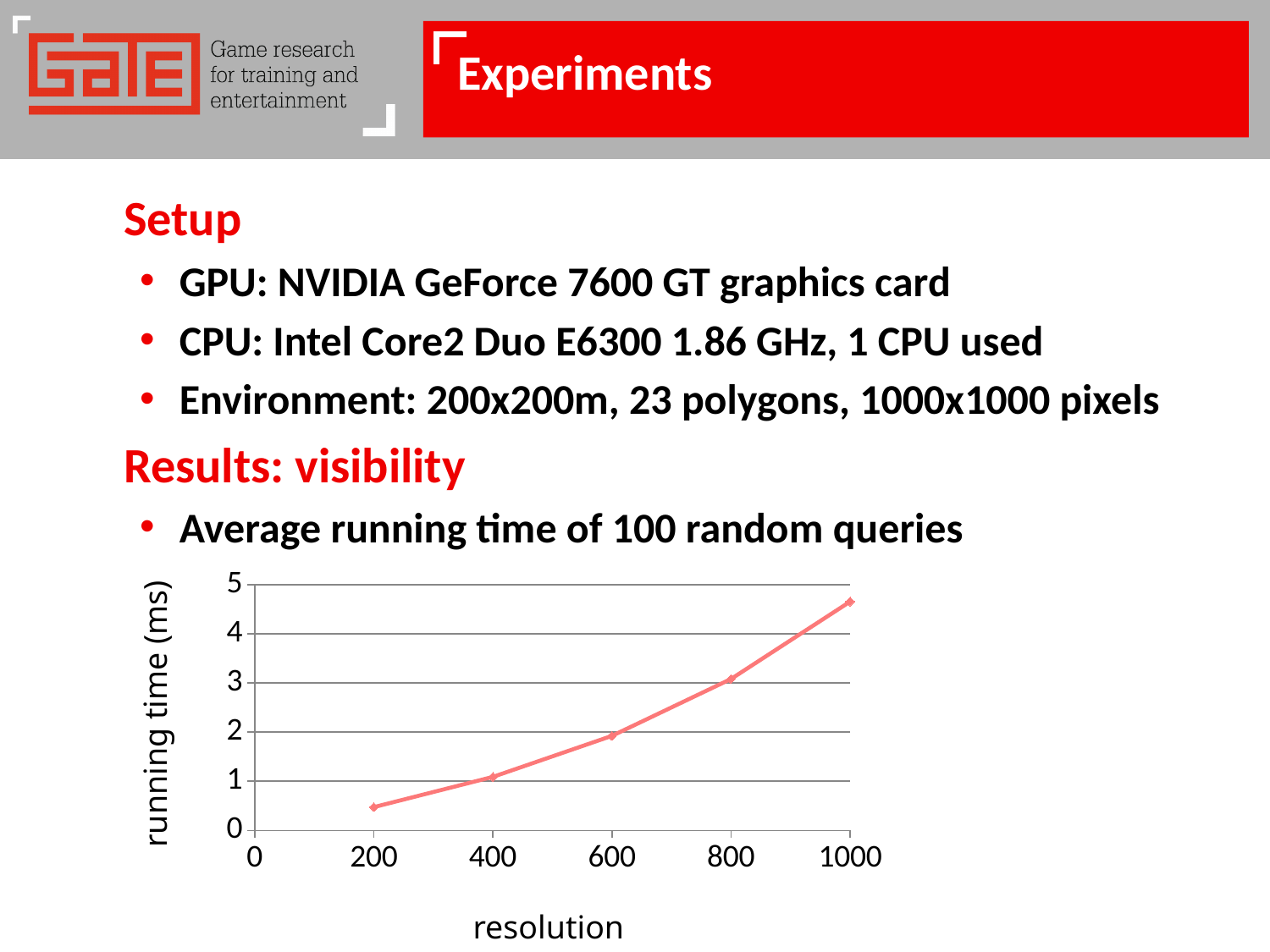
Is the running time at resolution 400 greater or less than 2 ms? less At which resolution is the running time lowest? 200 What is the label of the y axis of the chart? running time (ms) Is the running time at resolution 200 greater or less than 1 ms? less Is the running time at resolution 1000 greater or less than 4 ms? greater Does the running time rise or fall as resolution increases along the x axis? rise Which has the larger running time: resolution 400 or resolution 800? 800 How many data points are plotted on the line chart? 5 At which resolution is the running time highest? 1000 What kind of chart is shown on the slide? line chart